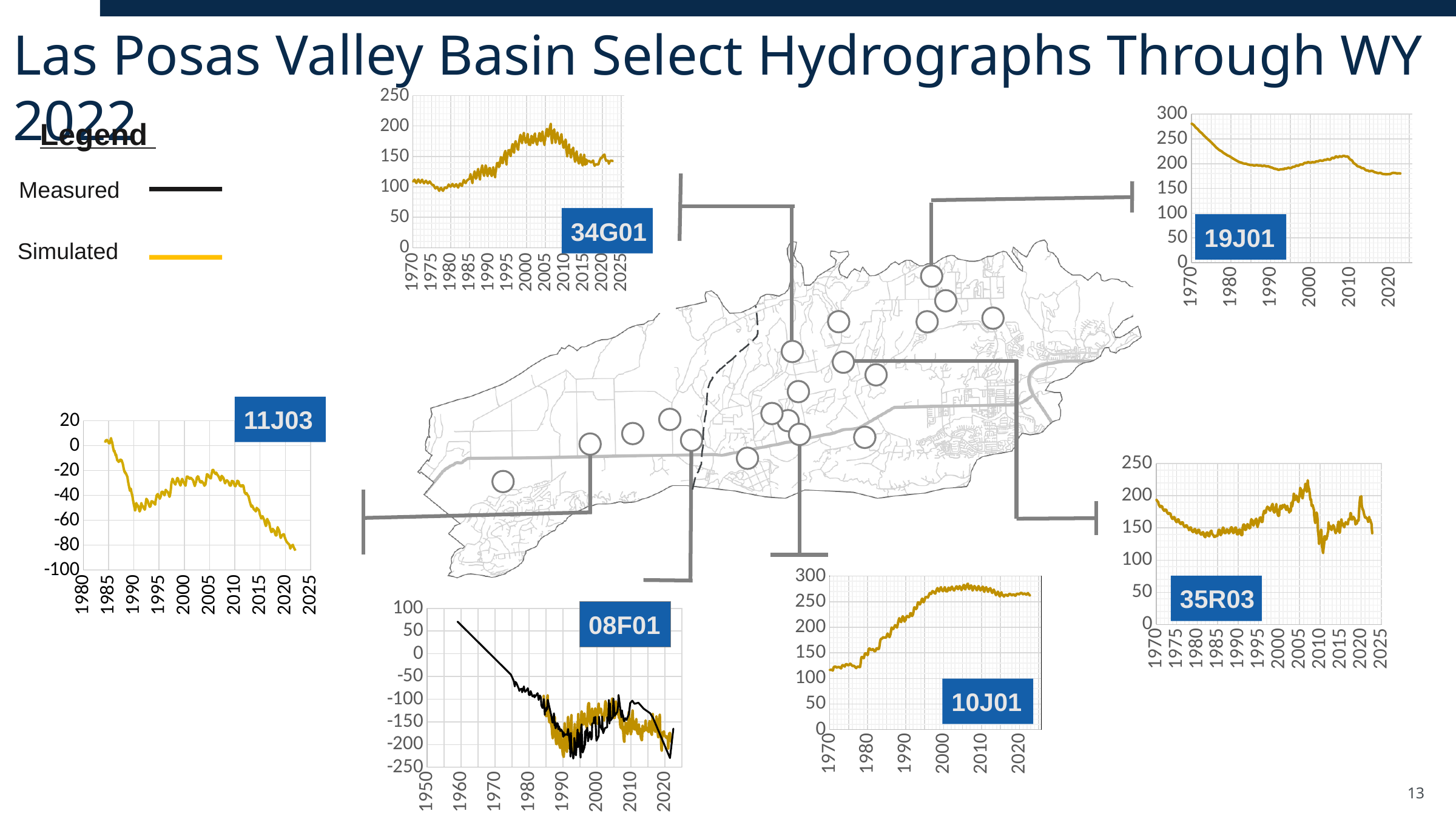
Which hydrograph on the slide shows both a Measured (black) line and a Simulated (yellow) line? 08F01 On the 11J03 chart, is the value in 2020 greater or less than -60? less On the 19J01 chart, is the value in 1970 greater or less than 250? greater What kind of chart is the 34G01 hydrograph? line chart On the 10J01 chart, do the values overall rise or fall from 1970 to 2020? rise On the 11J03 chart, do the values overall rise or fall from 1985 to 2020? fall On the 10J01 chart, is the value in 1970 greater or less than 150? less On the 19J01 chart, do the values overall rise or fall from 1970 to 2020? fall According to the legend, which colour line represents Simulated values? yellow